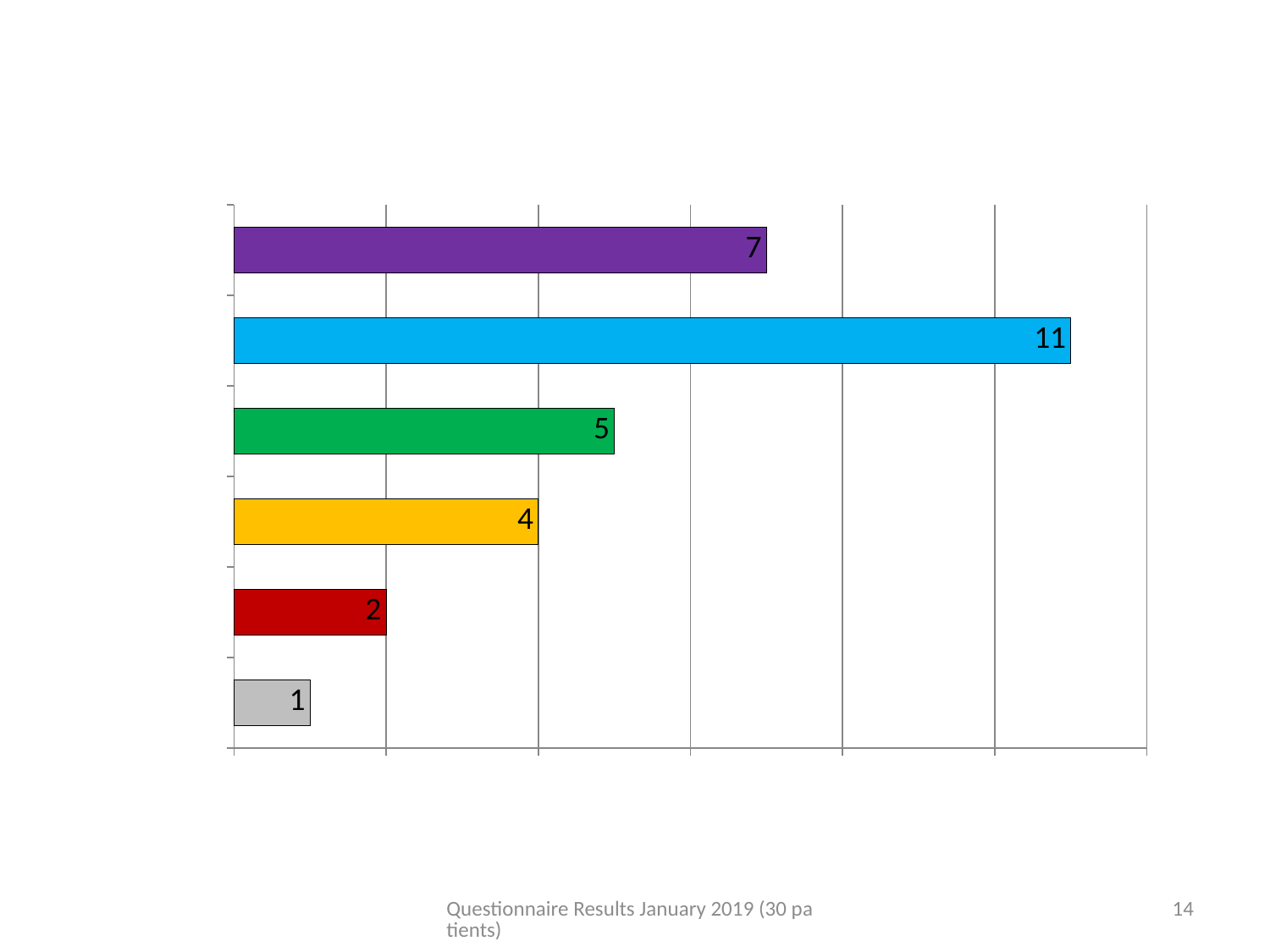
Which is larger, the green bar or the yellow bar? the green bar What is the value of the red bar? 2 What is the value of the grey bar at the bottom of the chart? 1 What is the value of the purple bar at the top of the chart? 7 What is the value of the yellow bar? 4 How many bars does the chart contain? 6 What kind of chart is shown on the slide? bar chart Which bar has the lowest value? the grey bar Which bar has the highest value? the blue bar What is the value of the blue bar? 11 What is the value of the green bar? 5 What is the difference between the blue bar and the purple bar? 4